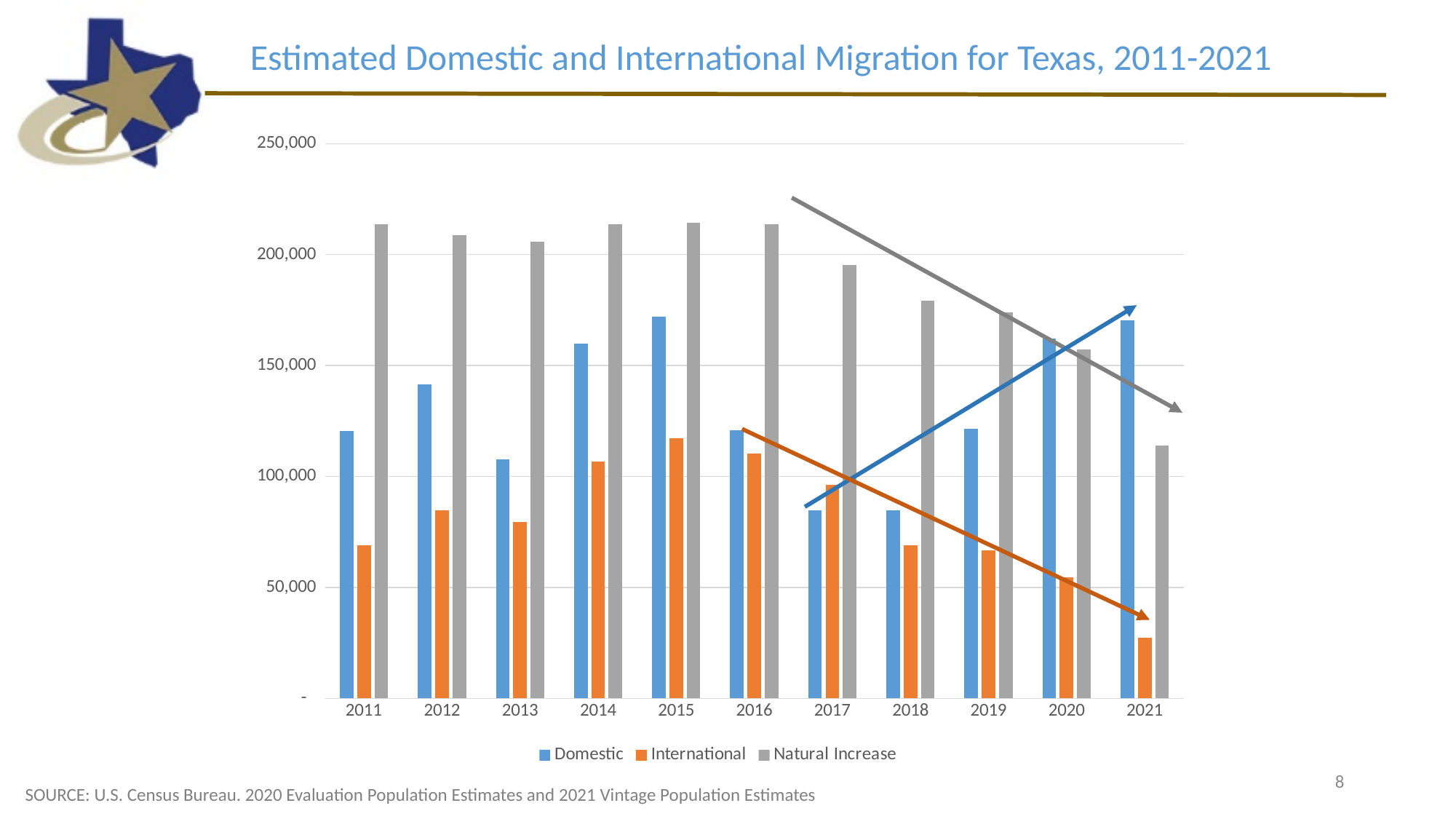
Is the Natural Increase value for 2011 greater or less than 200,000? greater In 2021, which is larger: Domestic or Natural Increase? Domestic Which year has the highest International value? 2015 What kind of chart is shown on the slide? Bar chart Is the Domestic value for 2017 greater or less than 100,000? less Which year has the lowest Natural Increase value? 2021 Does the International series rise or fall from 2015 to 2021? Fall Which year has the lowest International value? 2021 How many years are shown on the x axis? 11 Which series is shown in orange in the legend? International Is the International value for 2021 greater or less than 50,000? less How many series does the legend list? 3